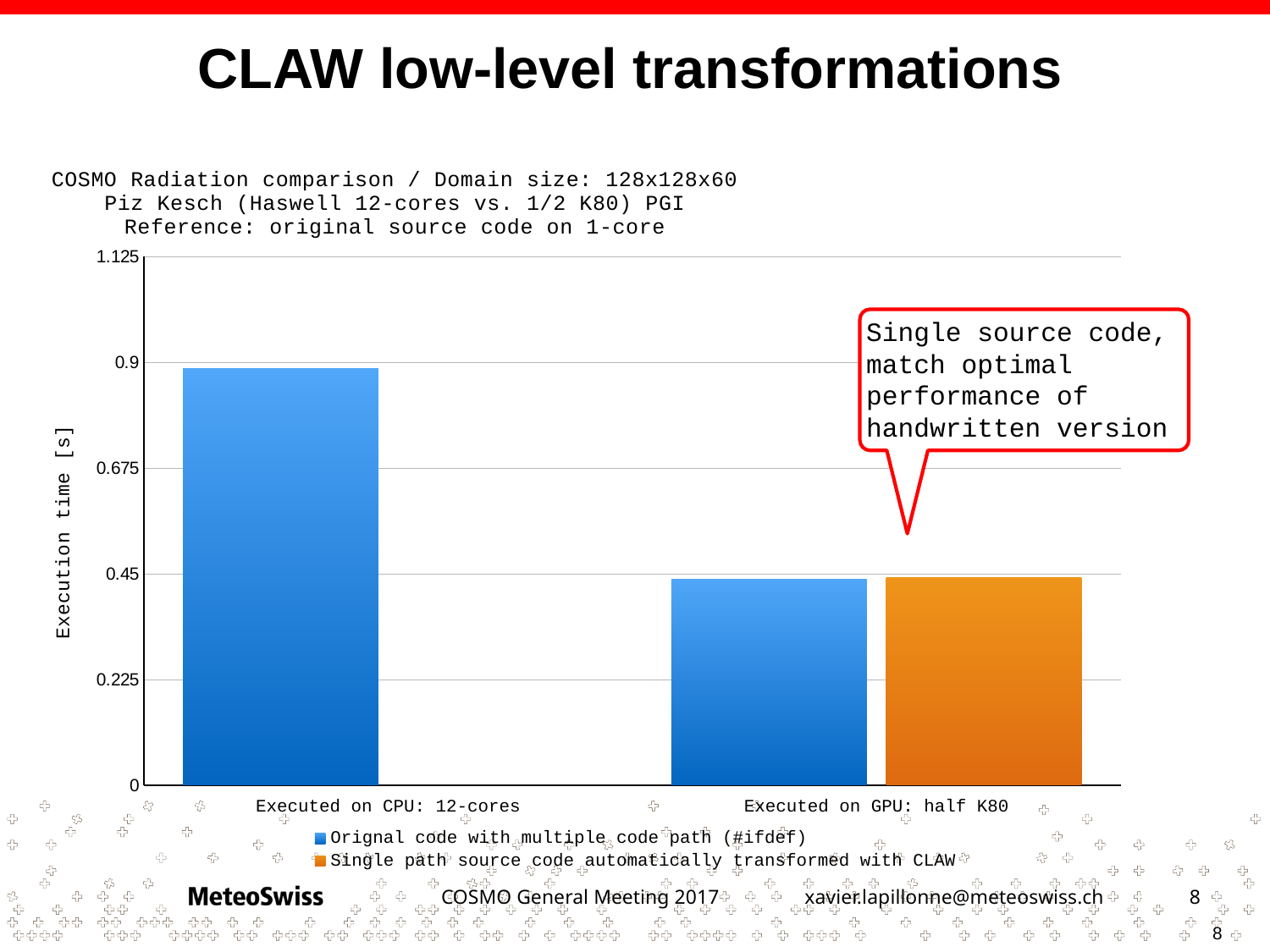
Is the execution time for the CLAW-transformed code executed on GPU: half K80 greater or less than 0.225? greater Which category has the highest bar in the chart? Executed on CPU: 12-cores Is the execution time for the original code executed on CPU: 12-cores greater or less than 0.675? greater What is the label of the y axis of the chart? Execution time [s] Which is larger: the execution time of the original code on CPU: 12-cores or on GPU: half K80? Executed on CPU: 12-cores How many series does the chart legend list? 2 Which series is shown in orange in the chart? Single path source code automatically transformed with CLAW What kind of chart is shown on the slide? bar chart How many categories are shown on the x axis of the chart? 2 Is the execution time for the original code executed on GPU: half K80 greater or less than 0.675? less Does the execution time of the original code rise or fall from the CPU category to the GPU category? fall